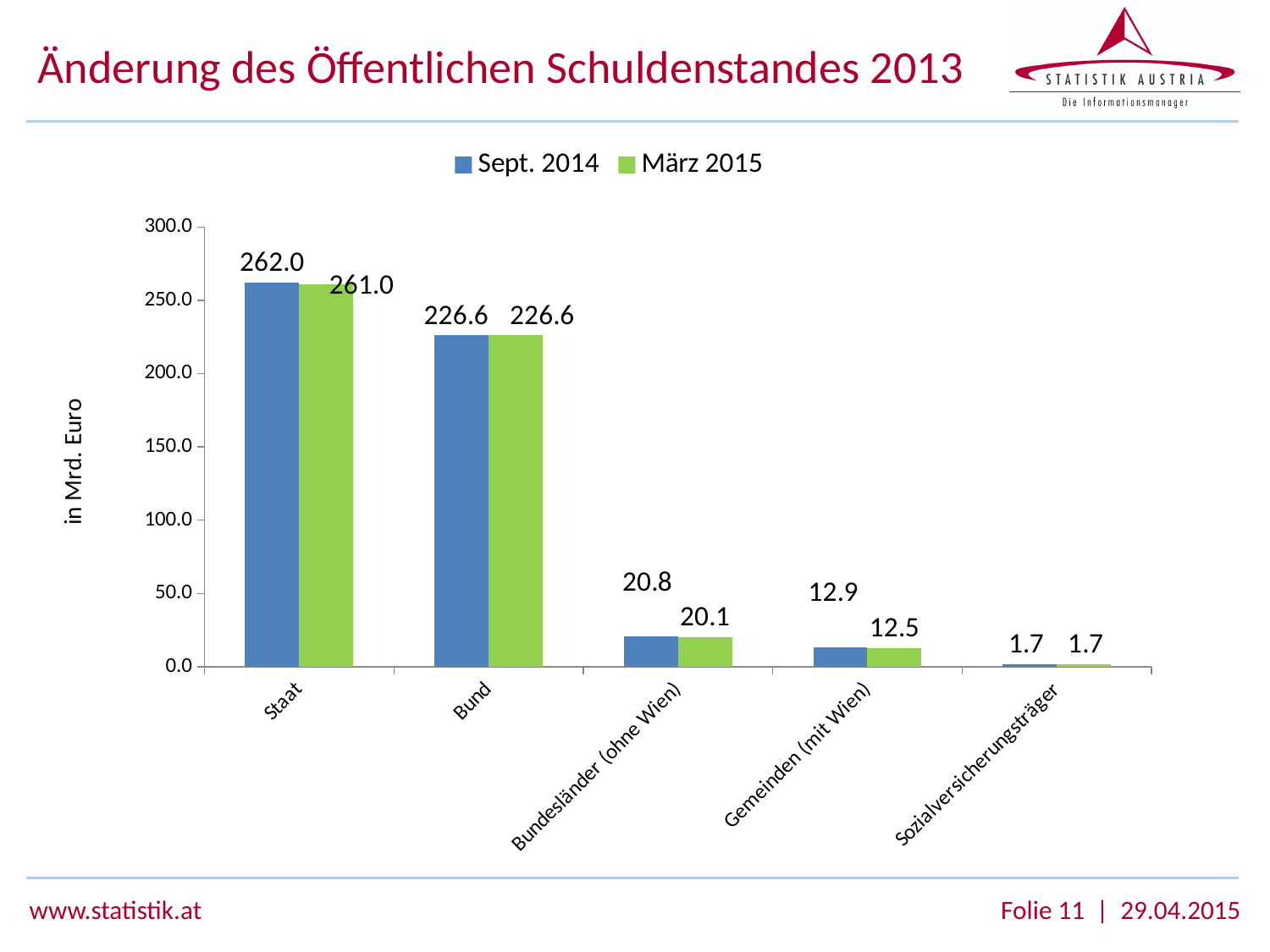
Which category has the lowest value in the Sept. 2014 series? Sozialversicherungsträger How many categories are shown on the x axis? 5 Which category has the highest value in the März 2015 series? Staat What is the difference between the Sept. 2014 and März 2015 values for Staat? 1.0 What kind of chart is shown on the slide? bar chart What is the value for Bundesländer (ohne Wien) in the März 2015 series? 20.1 What is the difference between the Sept. 2014 and März 2015 values for Bundesländer (ohne Wien)? 0.7 What is the value for Gemeinden (mit Wien) in the Sept. 2014 series? 12.9 How many series does the legend list? 2 Is the Sept. 2014 value for Gemeinden (mit Wien) larger or smaller than the März 2015 value? larger What is the value for Staat in the Sept. 2014 series? 262.0 What is the label of the y axis? in Mrd. Euro